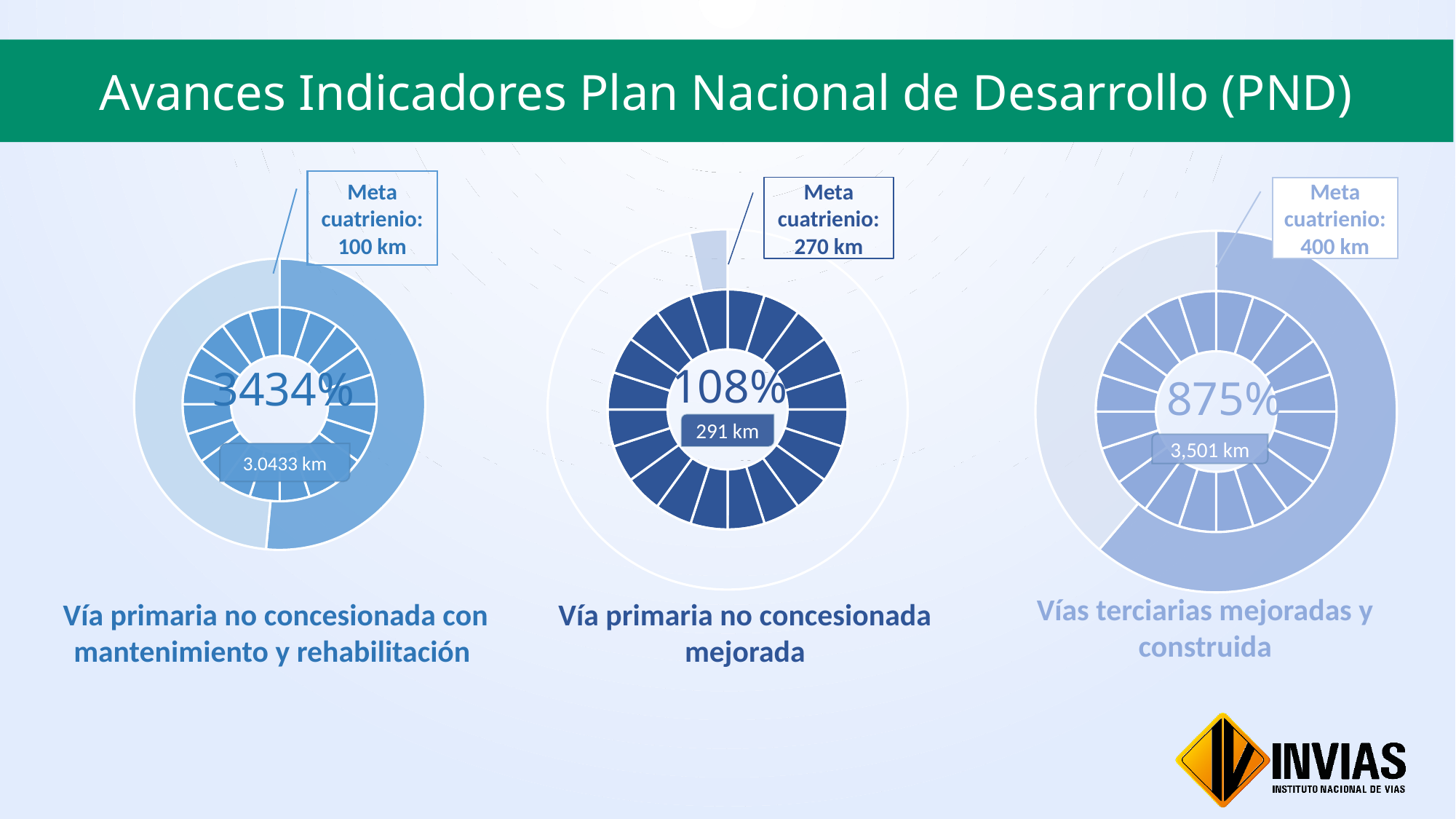
What percentage is shown in the centre of the 'Vías terciarias mejoradas y construida' chart? 875% What km value is shown on the 'Vía primaria no concesionada mejorada' chart? 291 km Which of the three charts shows the highest percentage? Vía primaria no concesionada con mantenimiento y rehabilitación What percentage is shown in the centre of the 'Vía primaria no concesionada con mantenimiento y rehabilitación' chart? 3434% What is the title of the slide? Avances Indicadores Plan Nacional de Desarrollo (PND) On the 'Vía primaria no concesionada mejorada' chart, by how many km does the achieved value exceed the 'Meta cuatrienio'? 21 km What km value is shown on the 'Vías terciarias mejoradas y construida' chart? 3,501 km What is the 'Meta cuatrienio' for the 'Vías terciarias mejoradas y construida' chart? 400 km How many donut charts are shown on the slide? 3 What is the 'Meta cuatrienio' for the 'Vía primaria no concesionada con mantenimiento y rehabilitación' chart? 100 km Which of the three charts shows the lowest percentage? Vía primaria no concesionada mejorada What percentage is shown in the centre of the 'Vía primaria no concesionada mejorada' chart? 108%